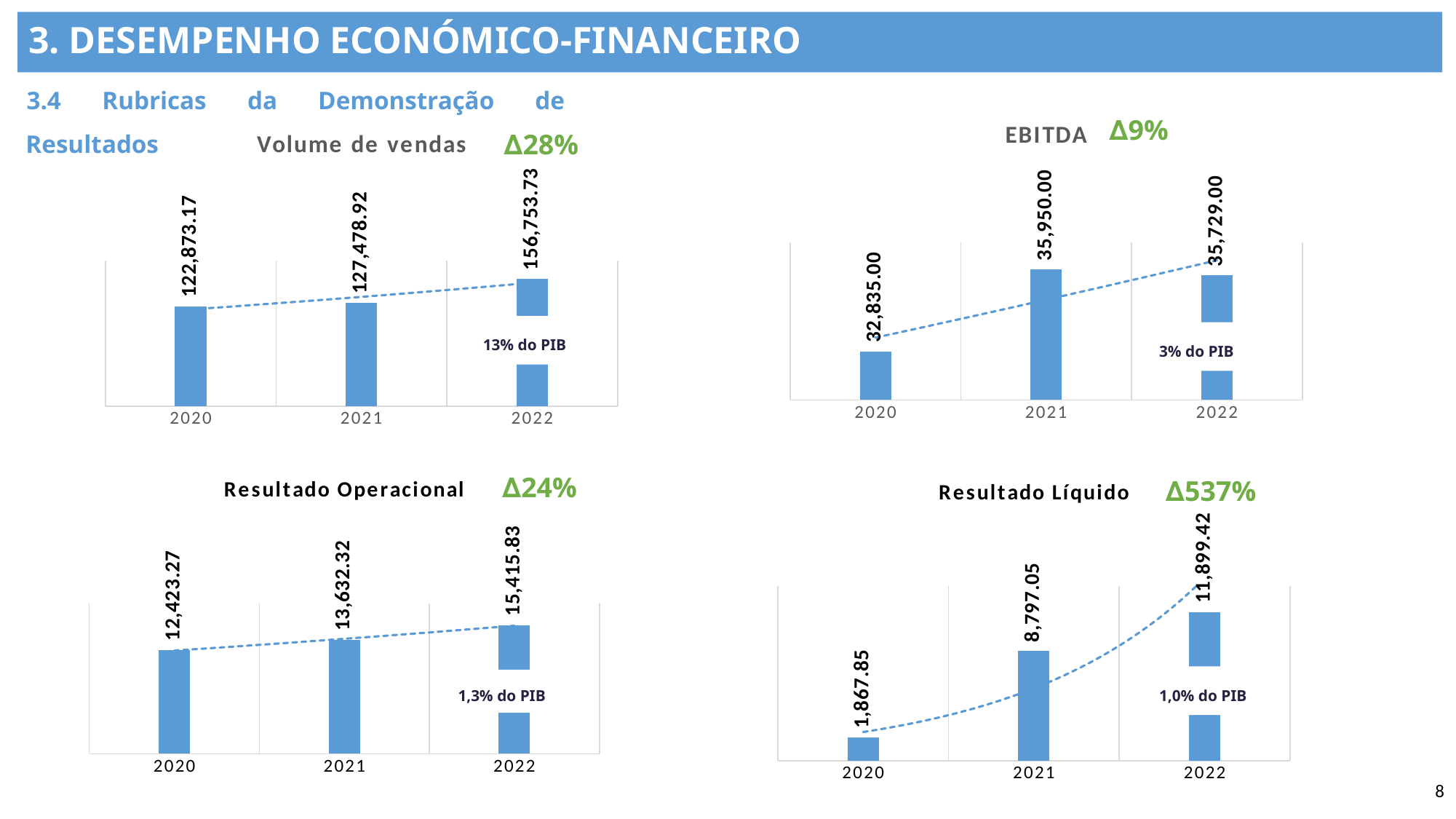
In the 'Resultado Operacional' chart, do the values rise or fall from 2020 to 2022? Rise In the 'EBITDA' chart, what is the value for 2020? 32,835.00 In the 'Resultado Líquido' chart, which year has the lowest value? 2020 In the 'Volume de vendas' chart, what is the difference between the 2022 and 2020 values? 33,880.56 What kind of chart is the 'Resultado Líquido' chart? Bar chart How many years are shown in the 'Resultado Operacional' chart? 3 In the 'EBITDA' chart, which year has the highest value? 2021 In the 'EBITDA' chart, which is larger: the value for 2021 or the value for 2022? 2021 What percentage change is shown next to the 'Resultado Líquido' chart title? Δ537% In the 'Resultado Operacional' chart, what is the value for 2021? 13,632.32 In the 'Resultado Líquido' chart, what is the value for 2022? 11,899.42 In the 'Volume de vendas' chart, what is the value for 2022? 156,753.73